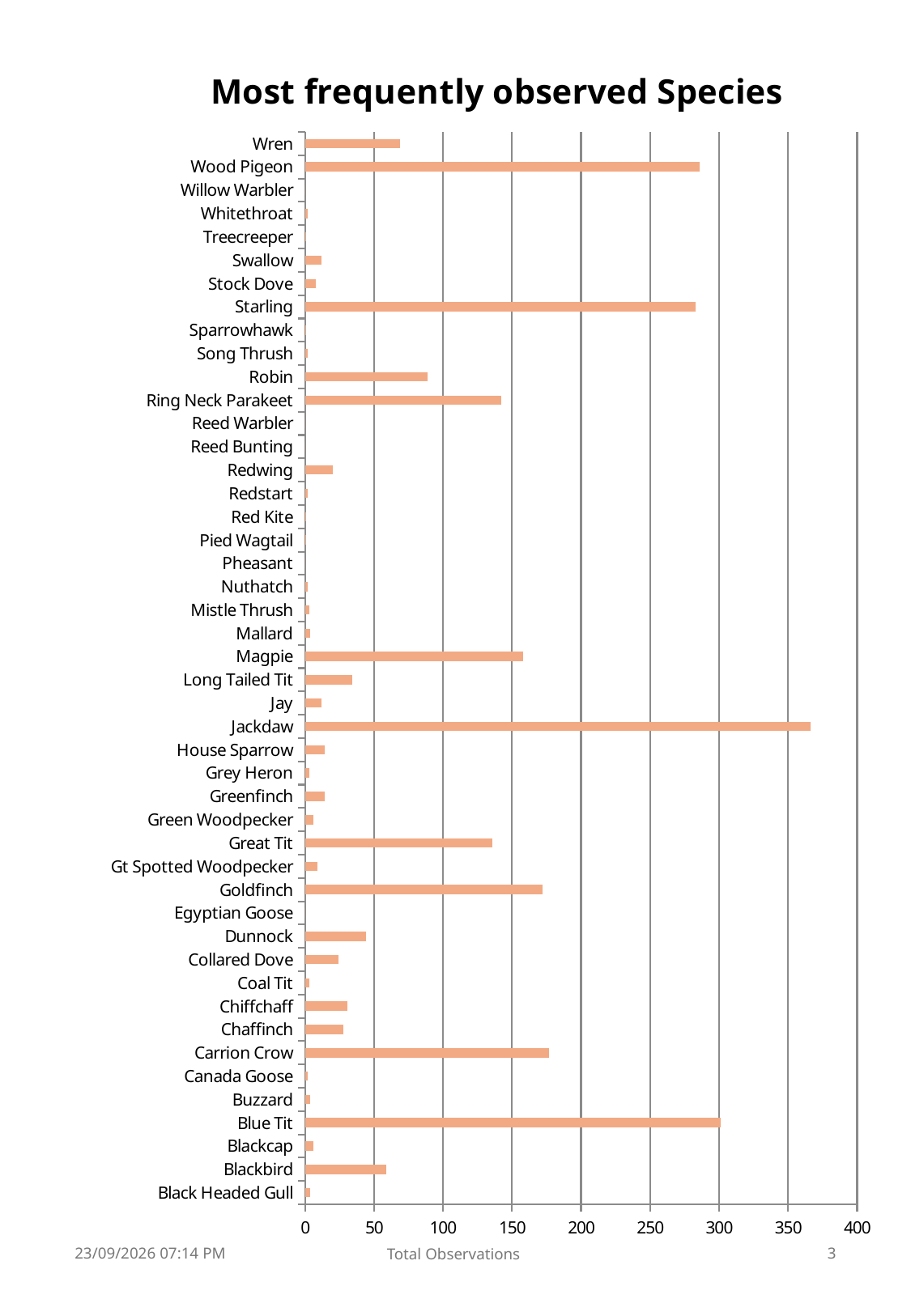
Is the value for Wood Pigeon greater or less than 250? greater Which has more total observations, Robin or Wren? Robin Is the value for Jackdaw greater or less than 350? greater What is the label on the horizontal axis of the chart? Total Observations Which has more total observations, Jackdaw or Blue Tit? Jackdaw Is the value for Great Tit greater or less than 150? less Which species has the highest number of total observations? Jackdaw What kind of chart is shown on the slide? bar chart How many species are listed on the chart? 46 What is the title of the chart? Most frequently observed Species